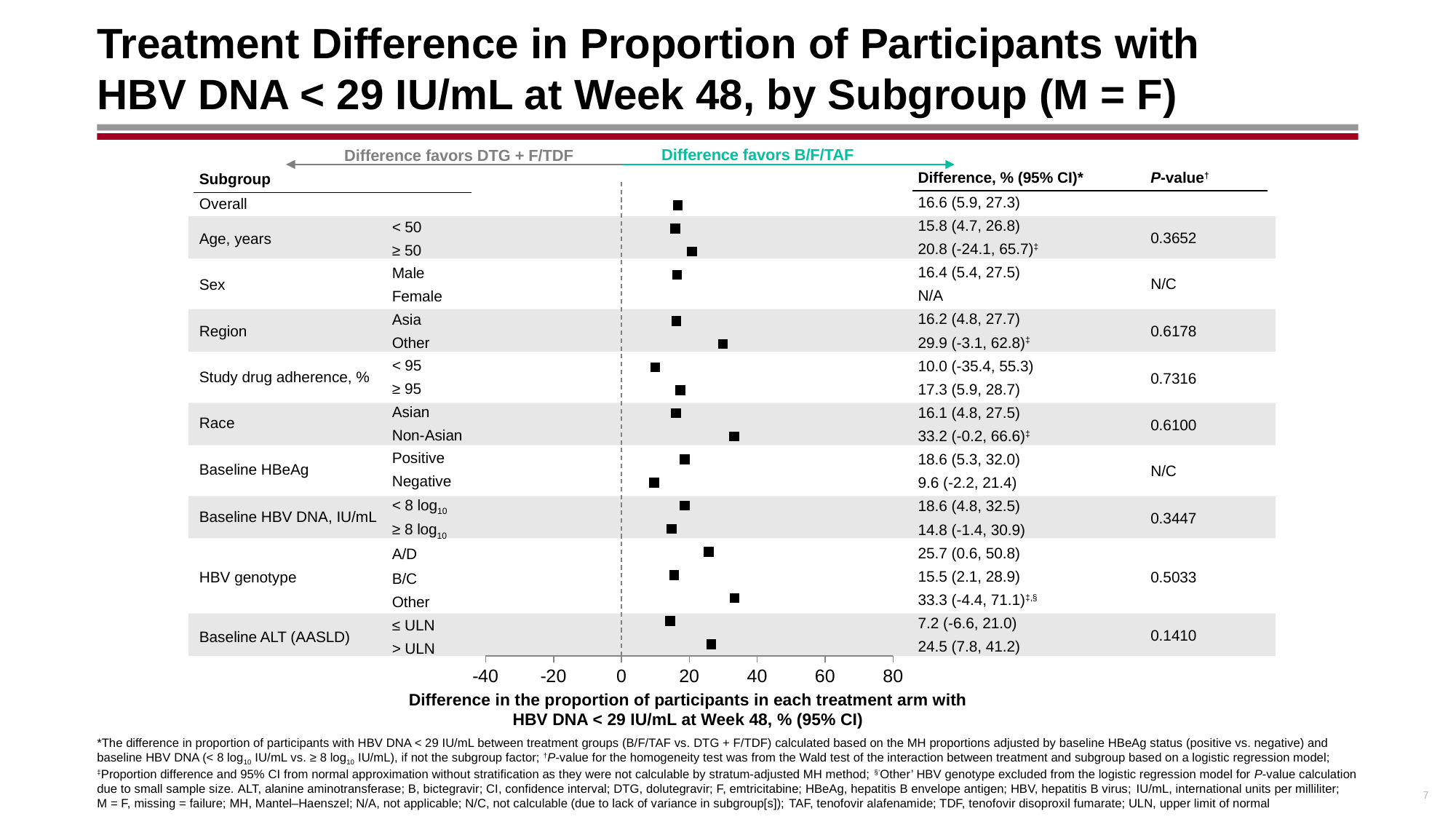
What is the overall treatment difference, % (95% CI), shown on the slide? 16.6 (5.9, 27.3) What is the treatment difference for the Baseline HBeAg Negative subgroup? 9.6 (-2.2, 21.4) What is the P-value for the Sex subgroup? N/C What is the treatment difference for the Region: Other subgroup? 29.9 (-3.1, 62.8) What is the difference between the point estimates for Baseline ALT > ULN and ≤ ULN? 17.3 Which subgroup category has the lowest point estimate of treatment difference? Baseline ALT ≤ ULN (7.2) What is the P-value for the Baseline ALT (AASLD) subgroup? 0.1410 According to the arrows above the plot, which treatment do differences to the right of zero favor? B/F/TAF What is the treatment difference for the HBV genotype A/D subgroup? 25.7 (0.6, 50.8) Which has the larger point estimate: Race Non-Asian or Race Asian? Non-Asian Is the point estimate for Study drug adherence < 95% greater or less than 20? less What kind of chart is shown on the slide? Forest plot